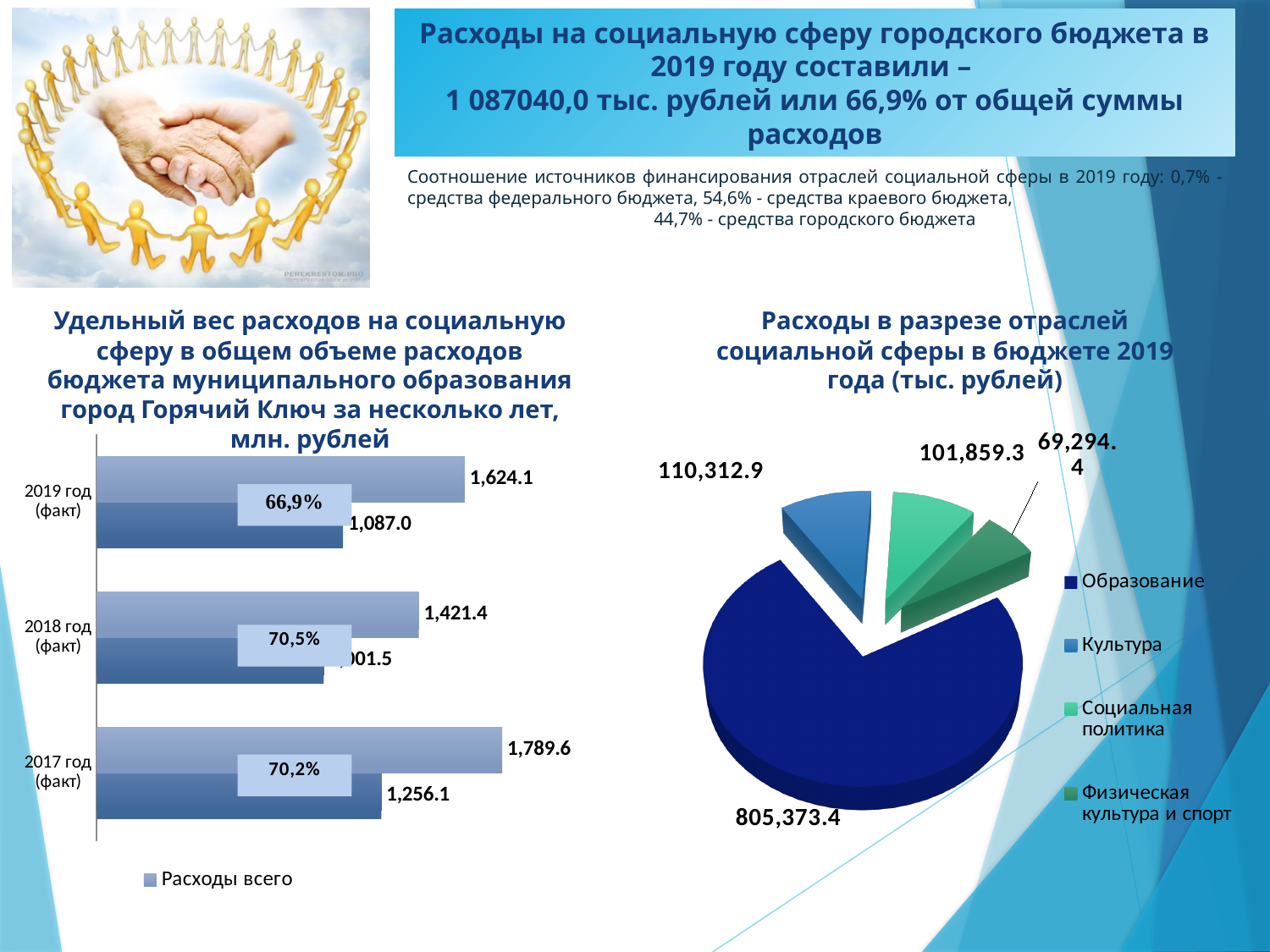
In the left bar chart, what is the value of Расходы всего for 2017 год (факт)? 1,789.6 What kind of chart is the right chart titled 'Расходы в разрезе отраслей социальной сферы в бюджете 2019 года'? pie chart In the right pie chart, what is the value for Образование? 805,373.4 In the right pie chart, what is the value for Культура? 110,312.9 How many year categories are shown in the left bar chart? 3 How many categories does the legend of the right pie chart list? 4 In the left bar chart, what percentage label is shown for 2018 год (факт)? 70,5% In the right pie chart, which category has the smallest slice? Физическая культура и спорт In the left bar chart, what is the difference between Расходы всего for 2017 год (факт) and 2018 год (факт)? 368.2 In the left bar chart, which year has the highest value of Расходы всего? 2017 год (факт) In the left bar chart, what is the value of Расходы всего for 2019 год (факт)? 1,624.1 What kind of chart is the left chart titled 'Удельный вес расходов на социальную сферу...'? bar chart